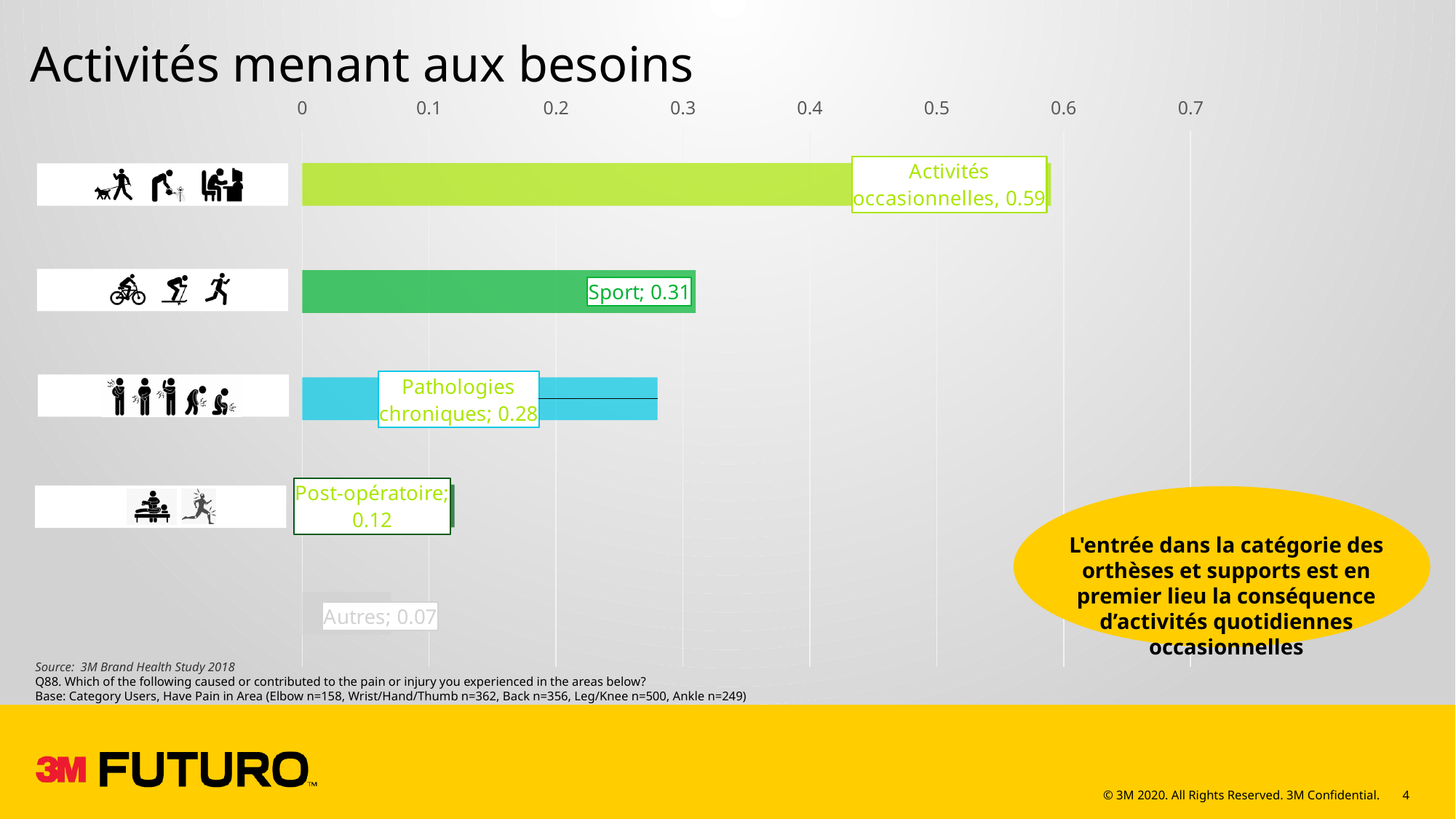
What is the value for Activités occasionnelles? 0.59 What is the value for Autres? 0.07 What is the value for Sport? 0.31 Which category has the highest value? Activités occasionnelles Which category has the lowest value? Autres What is the difference between the values for Activités occasionnelles and Sport? 0.28 Which is larger, the value for Sport or the value for Pathologies chroniques? Sport What is the value for Post-opératoire? 0.12 Is the value for Activités occasionnelles greater or less than 0.5? greater What is the value for Pathologies chroniques? 0.28 How many categories are shown in the chart? 5 What kind of chart is shown on the slide? Bar chart